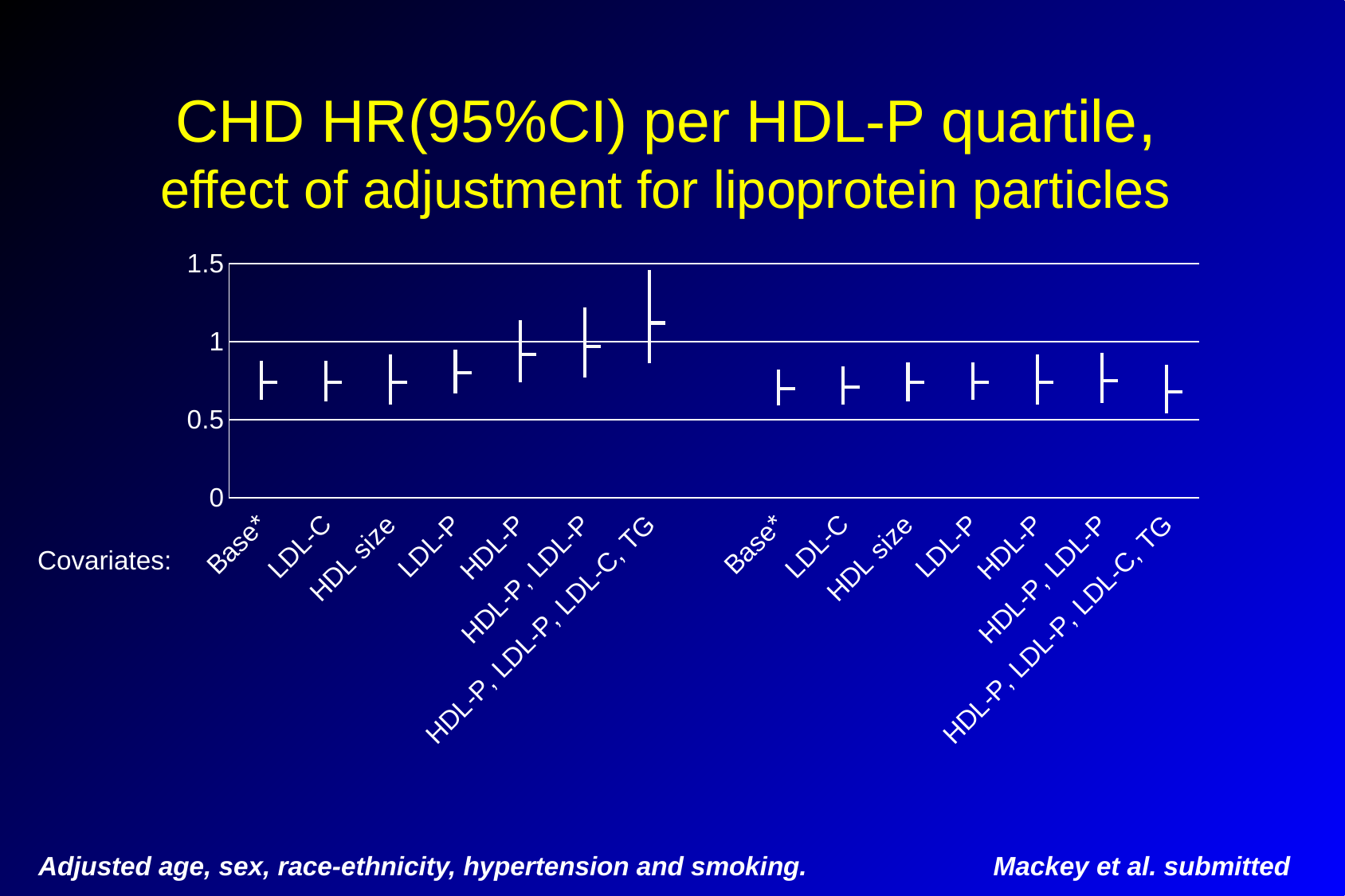
How many covariate sets are plotted in total across both groups on the chart? 14 In the left-hand group, do the hazard ratio point estimates rise or fall moving from Base* to HDL-P, LDL-P, LDL-C, TG? rise In the left-hand group, is the hazard ratio for Base* greater or less than 1? less In the left-hand group, is the hazard ratio for LDL-C greater or less than 0.5? greater What is the highest value shown on the y axis of the chart? 1.5 What kind of chart is shown on the slide? Error bar chart (point estimates with confidence intervals) How many covariate sets are plotted in the left-hand group of the chart? 7 What is the title of the chart on the slide? CHD HR(95%CI) per HDL-P quartile, effect of adjustment for lipoprotein particles In the left-hand group, which has the larger hazard ratio: Base* or HDL-P, LDL-P, LDL-C, TG? HDL-P, LDL-P, LDL-C, TG In the right-hand group, is the hazard ratio for Base* greater or less than 1? less Which covariate set has the highest hazard ratio point estimate on the chart? HDL-P, LDL-P, LDL-C, TG (left group)